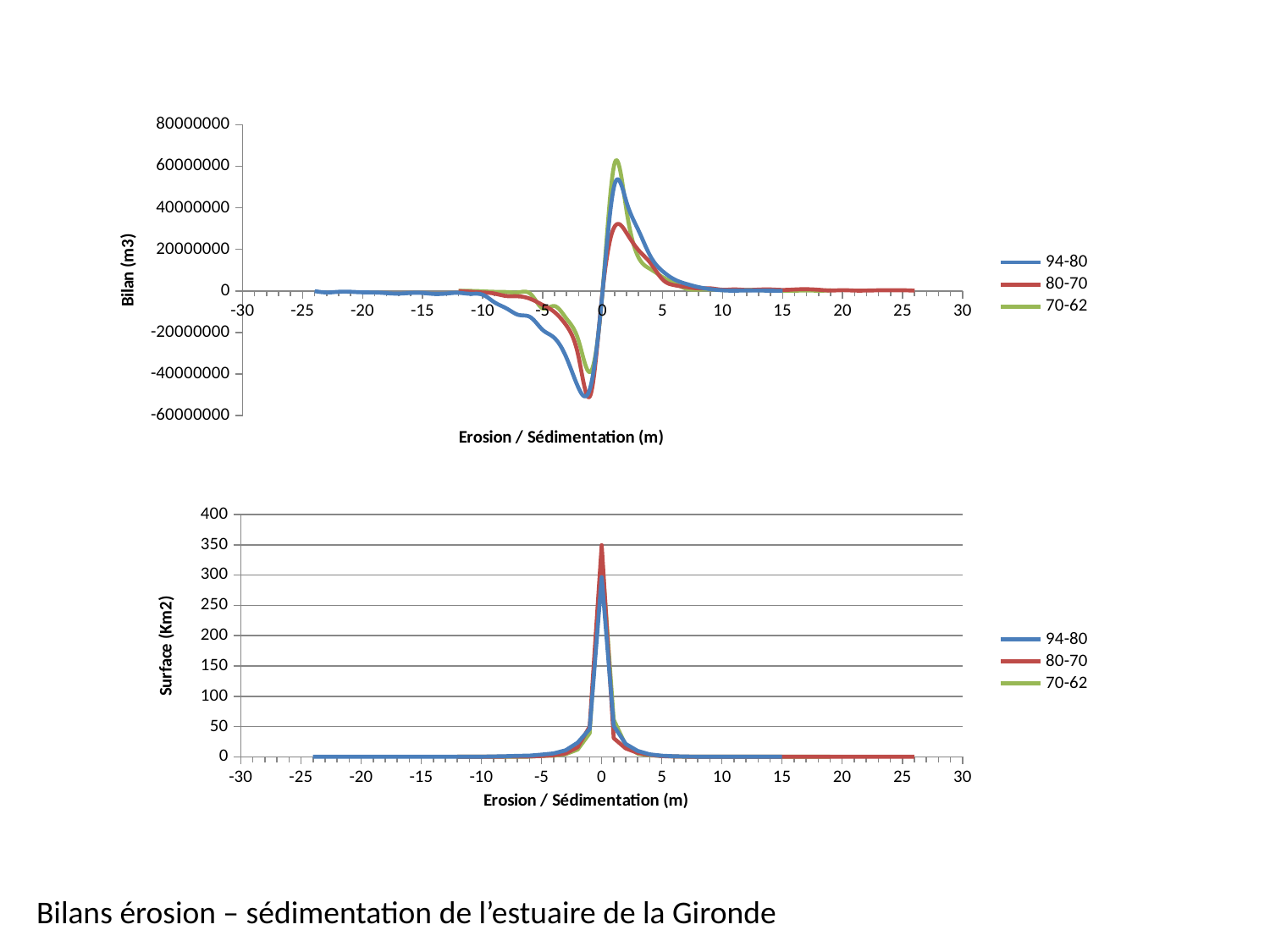
In the top chart, which series has the lowest positive peak? 80-70 In the bottom chart, is the peak value of the 80-70 series greater or less than 300? greater What kind of chart is the top chart on the slide? line chart In the bottom chart, which series reaches the highest peak value? 80-70 What is the y-axis title of the bottom chart? Surface (Km2) In the top chart, does the 94-80 series rise or fall between x = 1 and x = 10? fall In the top chart, which series reaches the highest peak value? 70-62 In the top chart, is the peak value of the 80-70 series greater or less than 20000000? greater In the top chart, is the peak value of the 80-70 series greater or less than 40000000? less How many series does the legend of the top chart list? 3 In the top chart, which series has the higher peak, 94-80 or 80-70? 94-80